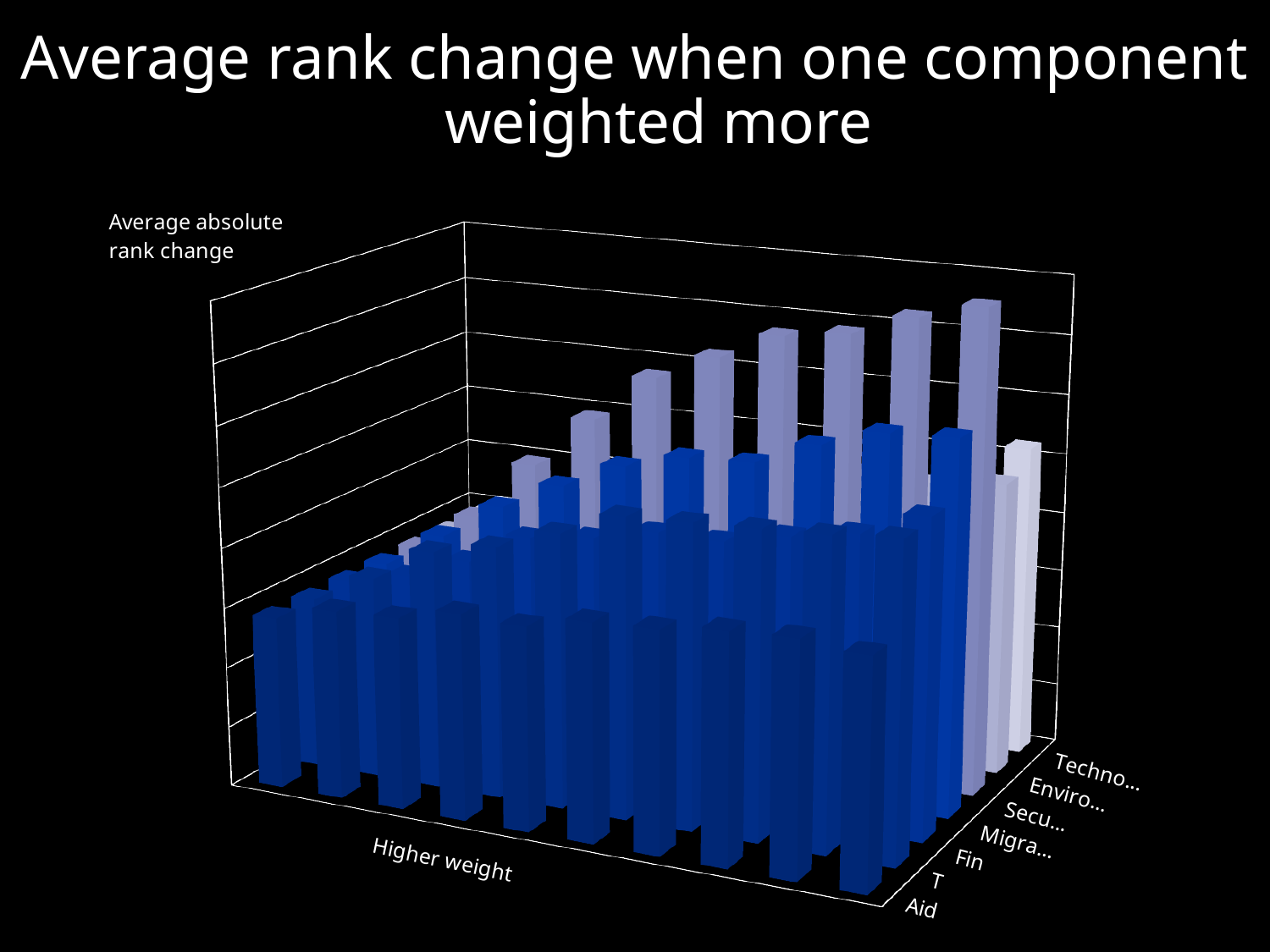
Which row of bars is at the front of the chart, nearest the viewer? Aid Which labelled row of bars contains the tallest bars in the chart? Secu... What label is shown on the vertical axis of the chart? Average absolute rank change How many labelled rows (series) are shown along the depth axis of the chart? 7 What kind of chart is shown on the slide? bar chart What is the title of the chart on the slide? Average rank change when one component weighted more